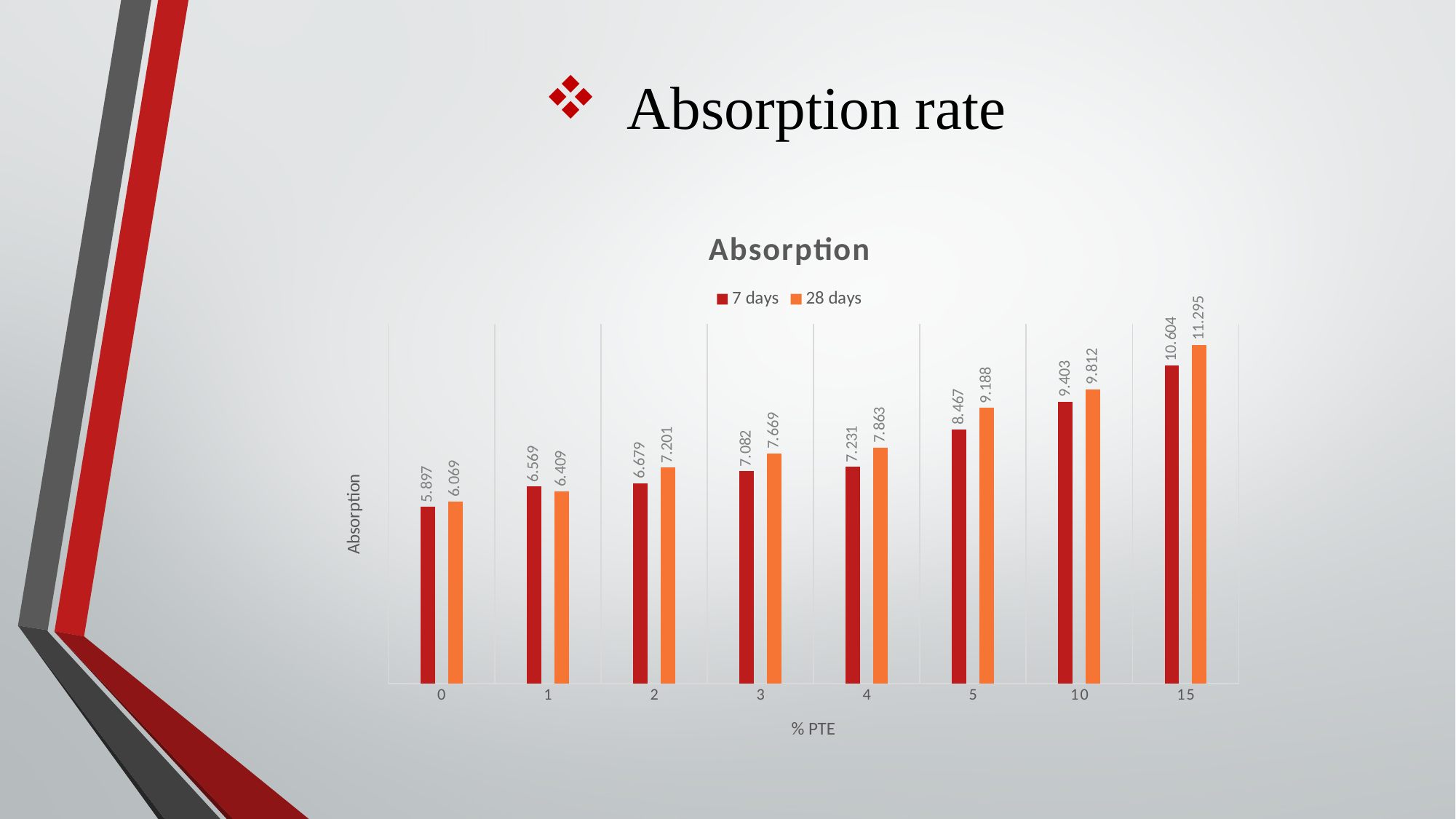
What is the 7 days absorption value at 0% PTE? 5.897 What is the 28 days absorption value at 5% PTE? 9.188 Do the 28 days absorption values rise or fall as % PTE increases from 0 to 15? Rise Which % PTE category has the lowest 28 days absorption value? 0 What is the title of the chart? Absorption What kind of chart is shown on the slide? Bar chart Which % PTE category has the highest 7 days absorption value? 15 How many % PTE categories are shown on the x axis? 8 What is the 28 days absorption value at 15% PTE? 11.295 How many series does the legend list? 2 What is the difference between the 28 days and 7 days absorption values at 10% PTE? 0.409 At 1% PTE, which series has the larger absorption value, 7 days or 28 days? 7 days